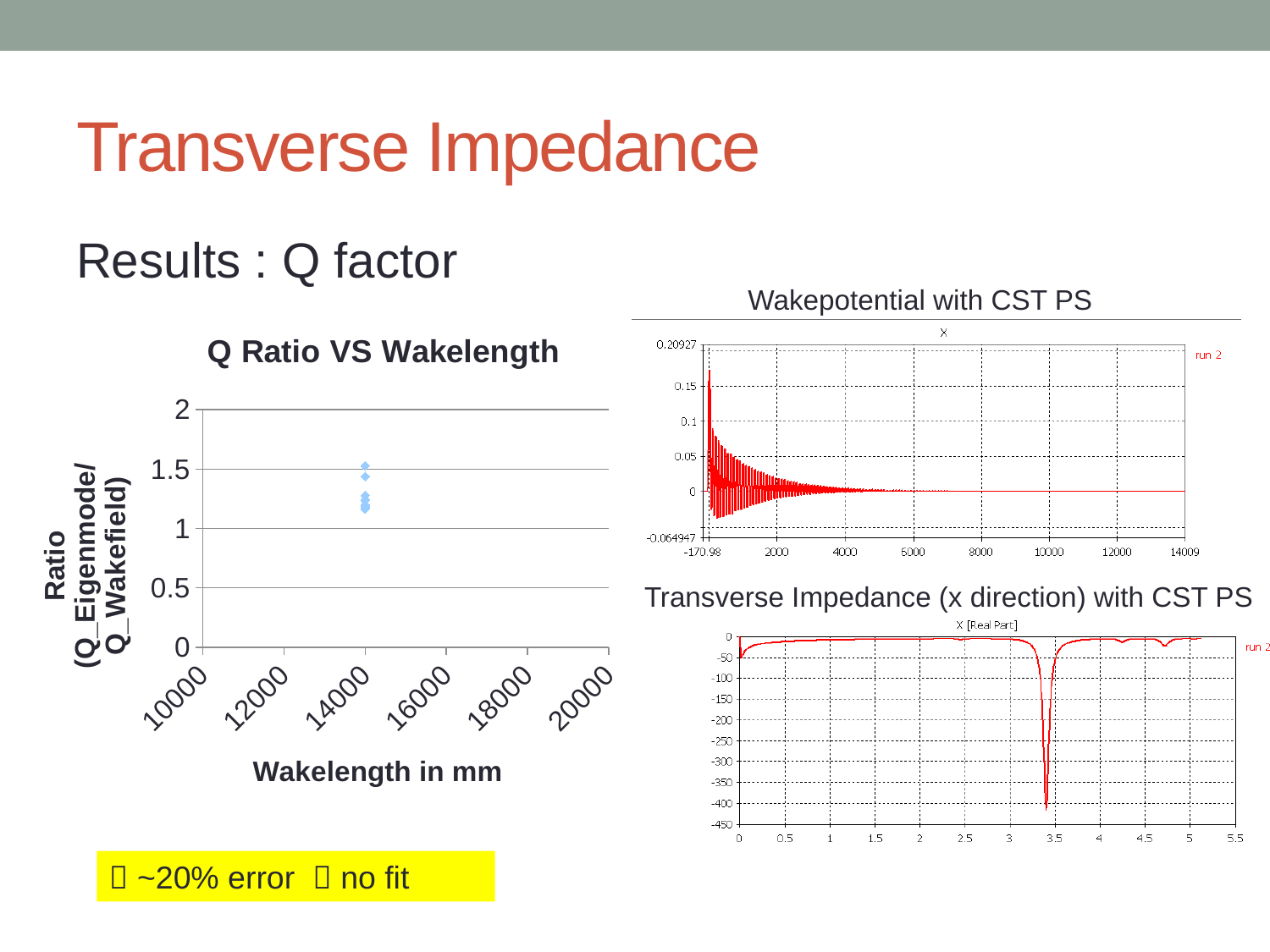
What is the title of the chart in the top right of the slide? Wakepotential with CST PS In the 'Wakepotential with CST PS' chart, what is the minimum value labelled on the y axis? -0.064947 In the 'Q Ratio VS Wakelength' chart, are the plotted ratio values greater or less than 1? greater In the 'Wakepotential with CST PS' chart, what is the last value labelled on the x axis? 14009 In the 'Wakepotential with CST PS' chart, what is the maximum value labelled on the y axis? 0.20927 What kind of chart is the 'Q Ratio VS Wakelength' chart? scatter chart In the 'Q Ratio VS Wakelength' chart, are the plotted ratio values greater or less than 2? less In the 'Transverse Impedance (x direction) with CST PS' chart, is the deepest dip located at an x value greater or less than 3? greater In the 'Q Ratio VS Wakelength' chart, what is the highest value shown on the y axis? 2 In the 'Wakepotential with CST PS' chart, does the amplitude of the oscillation grow or decay as x increases? decay In the 'Q Ratio VS Wakelength' chart, what is the x-axis title? Wakelength in mm